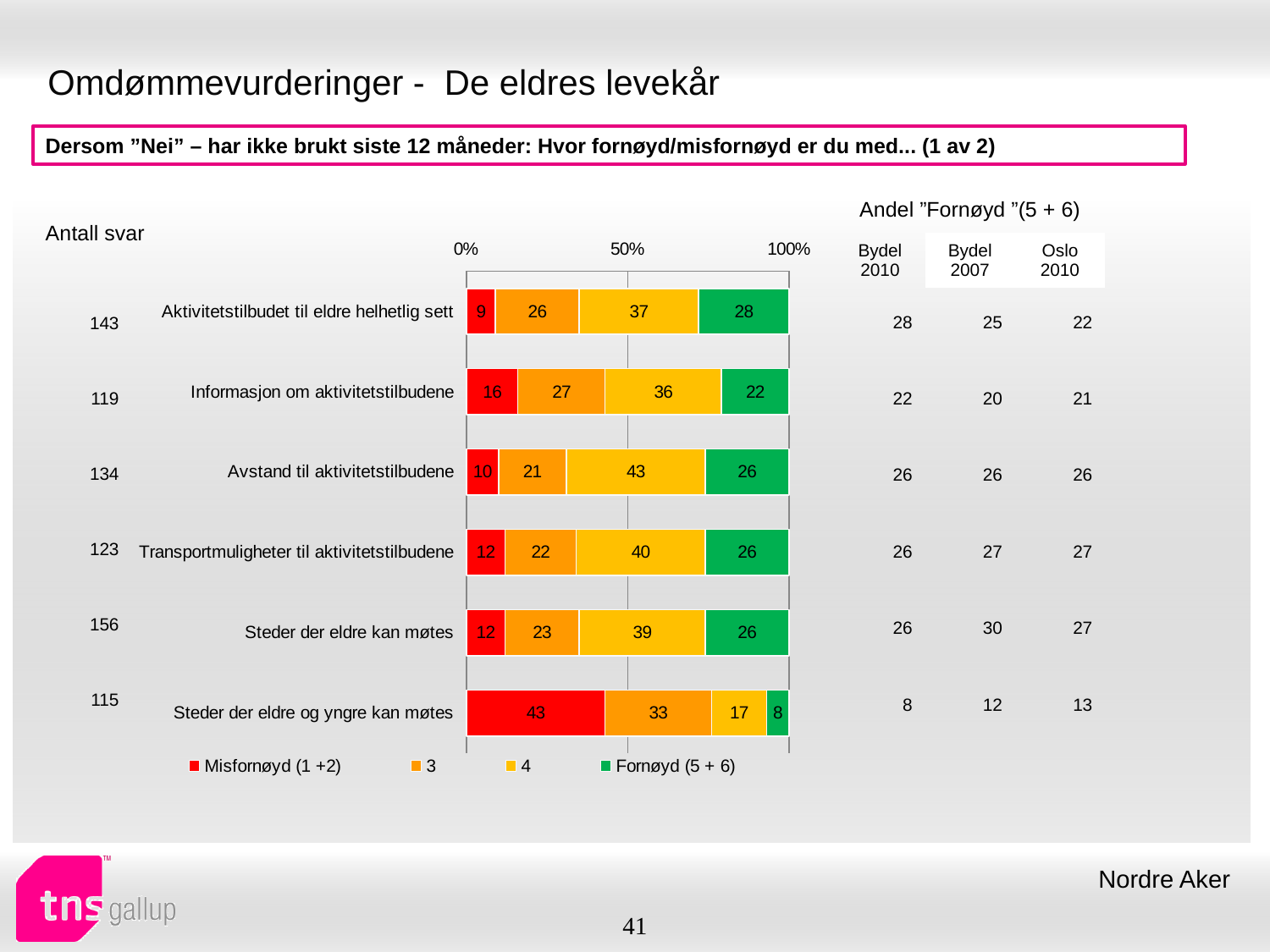
What is the value of series "4" for "Avstand til aktivitetstilbudene"? 43 What is the "Fornøyd (5 + 6)" value for "Aktivitetstilbudet til eldre helhetlig sett"? 28 What kind of chart is shown on the slide? Stacked bar chart Which category has the highest "Misfornøyd (1 +2)" value? Steder der eldre og yngre kan møtes What is the total of the stacked bar for "Steder der eldre kan møtes"? 100 How many categories (rows) does the chart show? 6 Which category has the lowest "Fornøyd (5 + 6)" value? Steder der eldre og yngre kan møtes Which legend entry is shown in green? Fornøyd (5 + 6) What is the difference between the "Misfornøyd (1 +2)" values for "Informasjon om aktivitetstilbudene" and "Aktivitetstilbudet til eldre helhetlig sett"? 7 Which is larger: the series "3" value for "Informasjon om aktivitetstilbudene" or for "Avstand til aktivitetstilbudene"? Informasjon om aktivitetstilbudene What is the "Misfornøyd (1 +2)" value for "Steder der eldre og yngre kan møtes"? 43 How many series does the legend list? 4